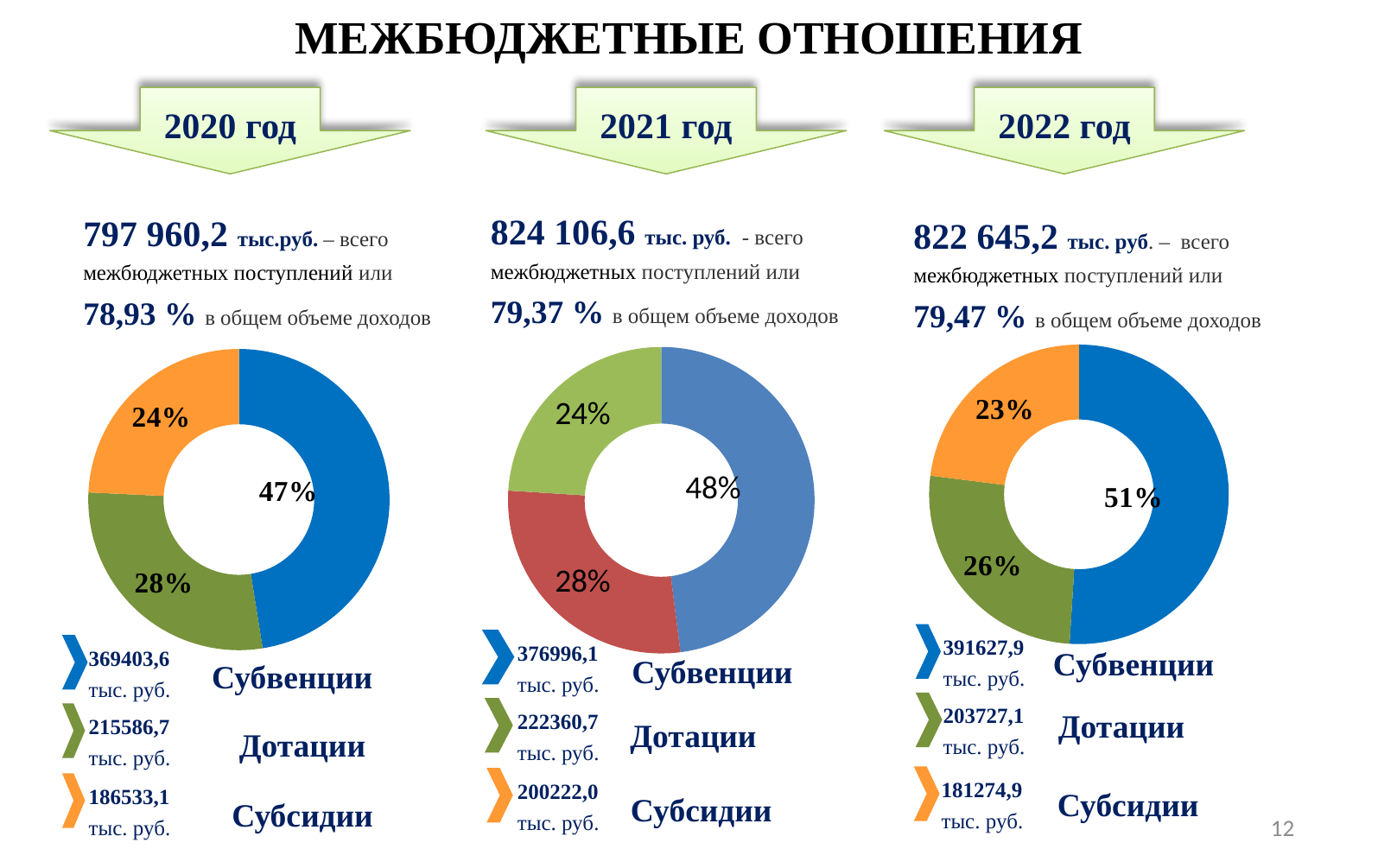
How many slices does the 2021 год chart have? 3 In the 2022 год chart, which category has the largest share? Субвенции In the 2020 год chart, what share of the total do Субвенции make up? 47% In the 2020 год chart, which category has the smallest share? Субсидии What kind of chart is used for the 2020 год data? Donut (pie) chart What is the amount of Субсидии shown for 2021 год? 200222,0 тыс. руб. In the 2021 год chart, which is larger: the share of Дотации or the share of Субсидии? Дотации How does the Субвенции share change across the three charts from 2020 to 2022? It rises (47%, 48%, 51%) In the 2021 год chart, what share of the total do Дотации make up? 28% In the 2022 год chart, what is the difference in percentage points between the Субвенции share and the Дотации share? 25 percentage points What is the amount of Субвенции shown for 2020 год? 369403,6 тыс. руб. In the 2022 год chart, what share of the total do Субсидии make up? 23%